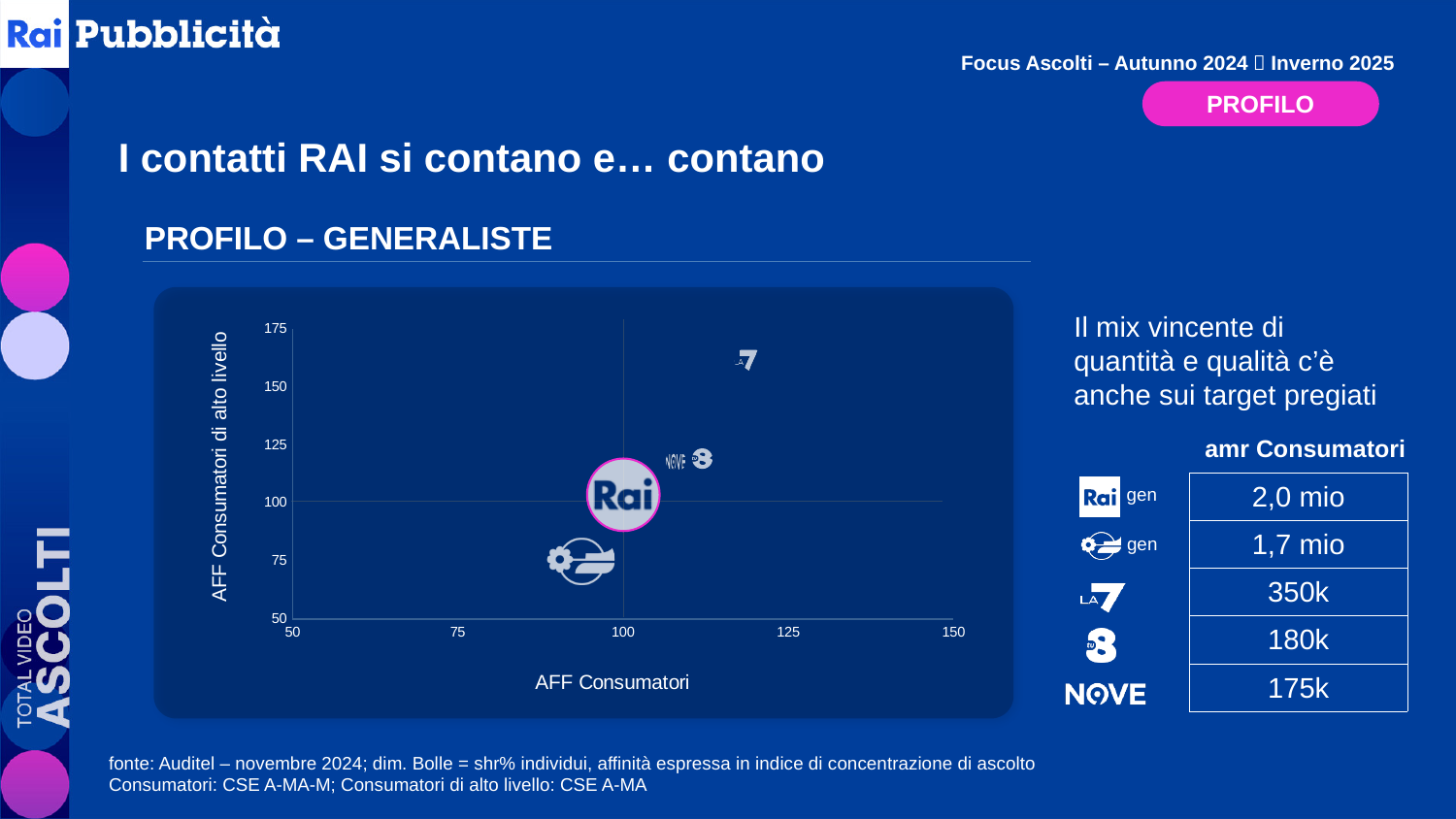
Which broadcaster has the lowest value on the AFF Consumatori axis? Mediaset What is the title above the chart? PROFILO – GENERALISTE What kind of chart is shown on the slide? bubble chart Is the AFF Consumatori di alto livello value for Mediaset greater or less than 100? less Which broadcaster has the highest value on the AFF Consumatori axis? La7 Is the AFF Consumatori di alto livello value for La7 greater or less than 150? greater Is the AFF Consumatori di alto livello value for TV8 greater or less than 100? greater Which broadcaster has the lowest value on the AFF Consumatori di alto livello axis? Mediaset How many broadcasters are plotted on the chart? 5 Which has a higher AFF Consumatori di alto livello value, Rai or Mediaset? Rai What is the label of the horizontal axis of the chart? AFF Consumatori Which broadcaster has the highest value on the AFF Consumatori di alto livello axis? La7